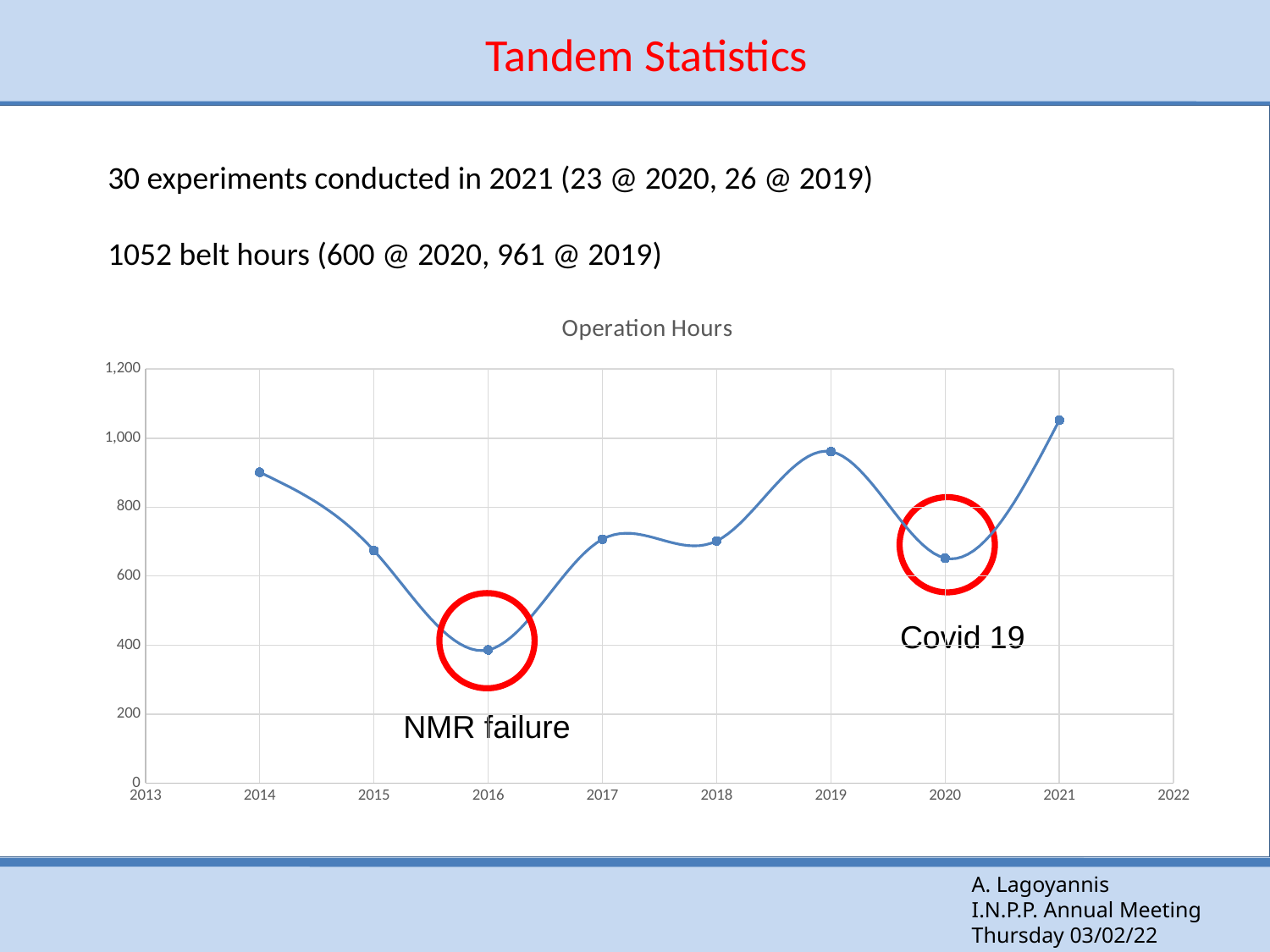
How many data points are plotted on the chart? 8 Is the value for 2021 greater or less than 1,000? greater What annotation is written next to the circled point at 2016? NMR failure Which year has the highest operation hours on the chart? 2021 Is the value for 2014 greater or less than 800? greater Is the value for 2016 greater or less than 600? less What kind of chart is shown on the slide? line chart What is the title of the chart? Operation Hours Which year has the lowest operation hours on the chart? 2016 Do the operation hours rise or fall from 2014 to 2016? fall Which year has higher operation hours, 2019 or 2020? 2019